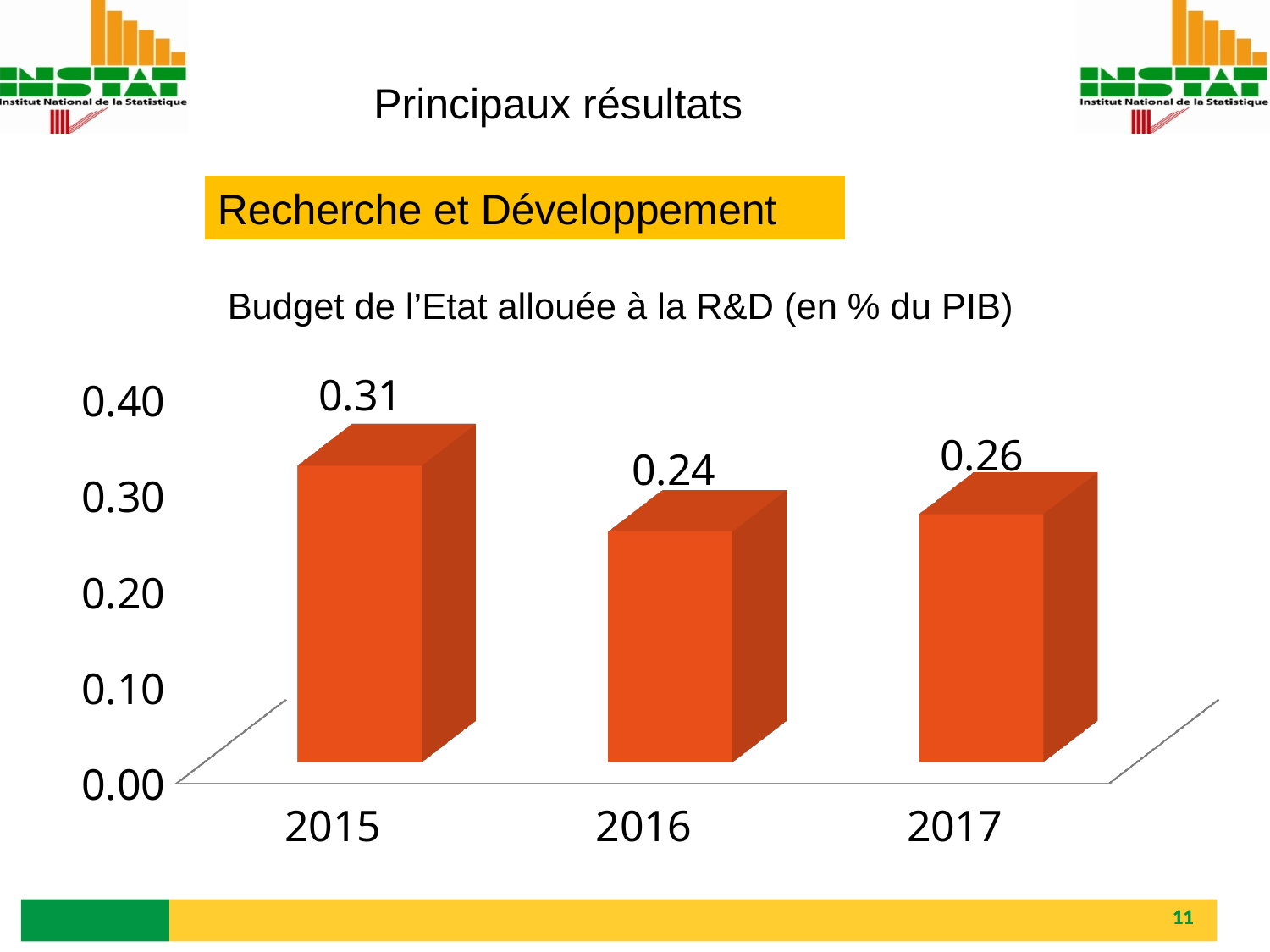
What kind of chart is shown on the slide? bar chart What is the value for 2016? 0.24 Which is larger, the value for 2015 or the value for 2017? 2015 Is the value for 2016 greater or less than 0.30? less Which year has the lowest value? 2016 What is the difference between the values for 2017 and 2016? 0.02 What is the value for 2015? 0.31 What is the title of the chart? Budget de l'Etat allouée à la R&D (en % du PIB) What is the difference between the values for 2015 and 2016? 0.07 How many years are shown on the chart? 3 What is the value for 2017? 0.26 Which year has the highest value? 2015